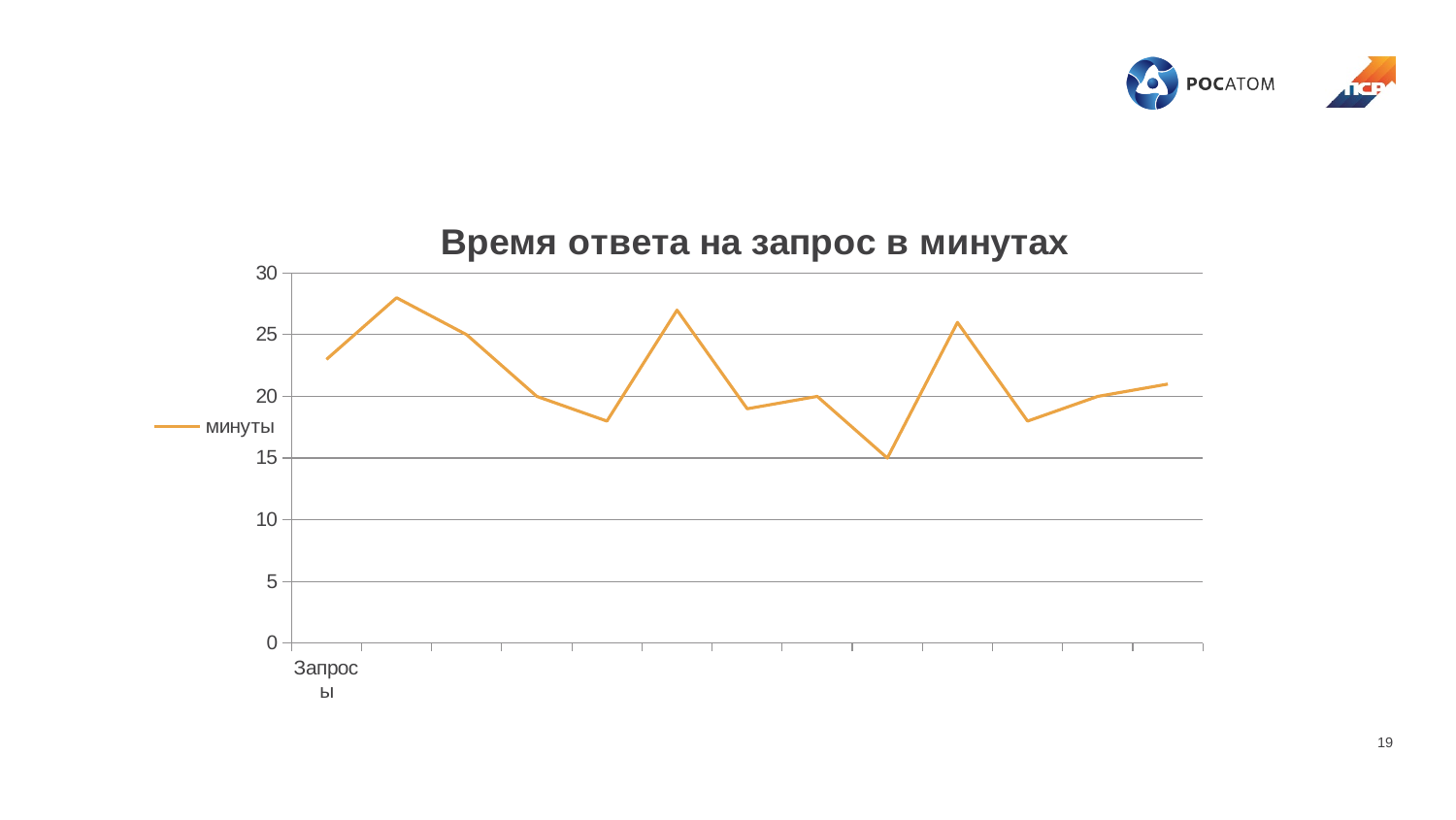
How many series does the legend list? 1 How many data points are plotted on the line? 13 What kind of chart is shown on the slide? line chart Is the value of the second point on the line greater or less than 25? greater Is the value of the first point on the line greater or less than 20? greater What is the title of the chart? Время ответа на запрос в минутах What is the name of the series shown in the legend? минуты What is the highest value shown on the vertical axis? 30 Is the value of the ninth point on the line greater or less than 20? less Which point on the line has the highest value: the second point or the ninth point? the second point Does the line rise or fall between the first and second points? rise